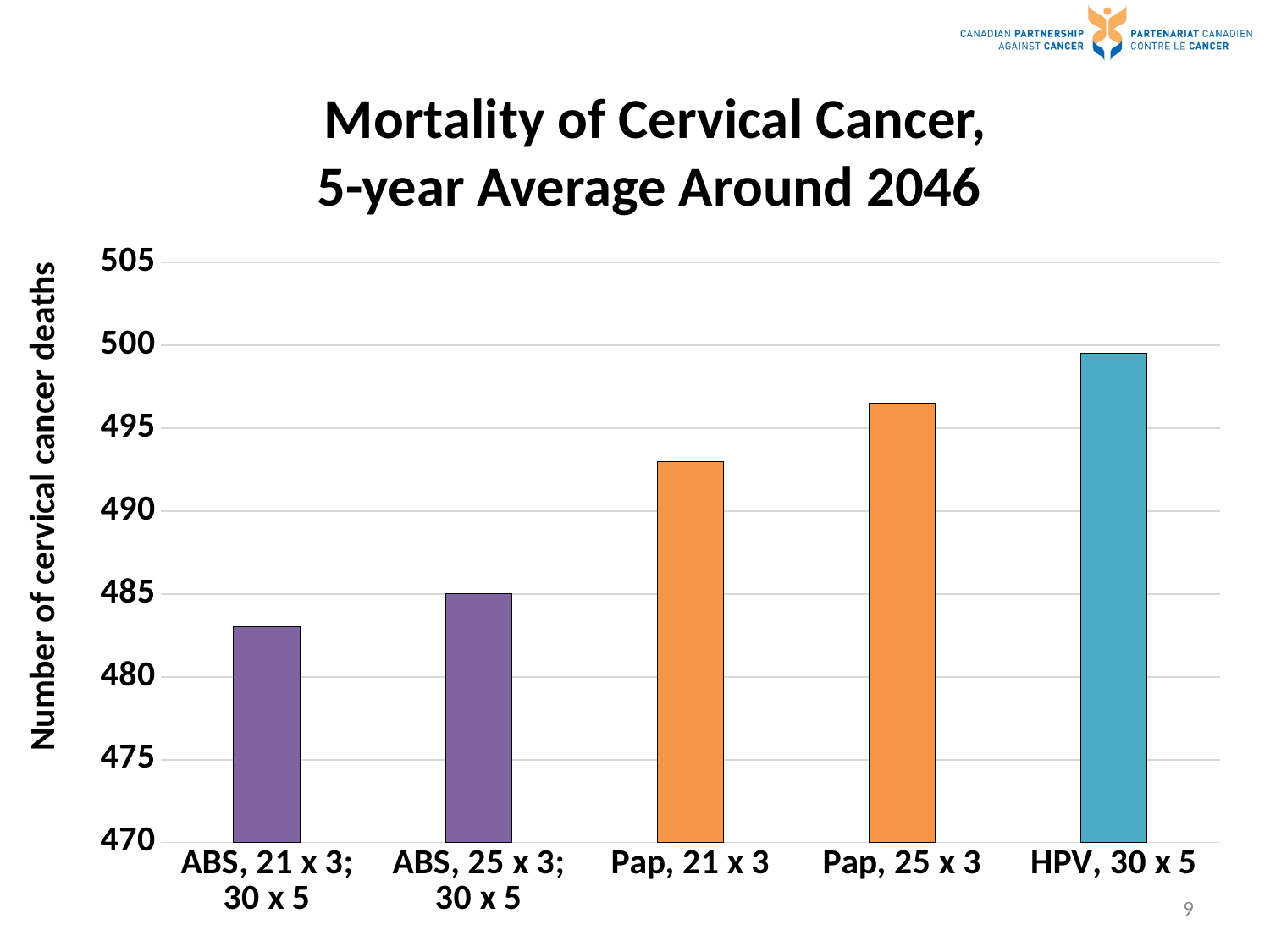
How many categories (bars) are shown in the chart? 5 Is the value for HPV, 30 x 5 greater or less than 495? greater Is the value for Pap, 21 x 3 greater or less than 490? greater Is the value for ABS, 25 x 3; 30 x 5 greater or less than 490? less What is the label of the vertical axis? Number of cervical cancer deaths What kind of chart is shown on the slide? bar chart Which is larger, the value for Pap, 21 x 3 or the value for ABS, 25 x 3; 30 x 5? Pap, 21 x 3 Do the values rise or fall moving from left to right across the categories? rise Which category has the highest number of cervical cancer deaths? HPV, 30 x 5 Which category has the lowest number of cervical cancer deaths? ABS, 21 x 3; 30 x 5